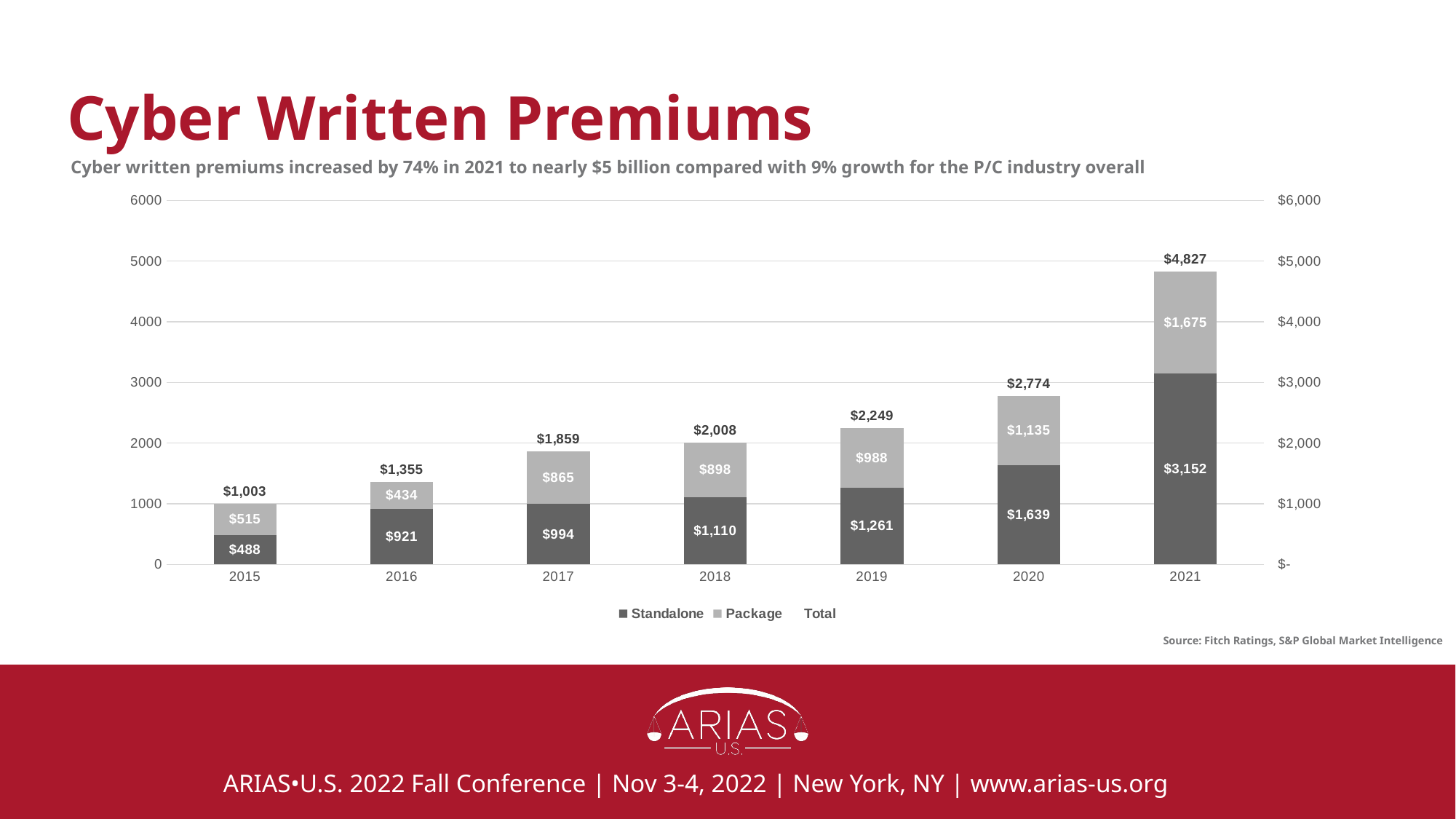
What is the source cited for the chart? Fitch Ratings, S&P Global Market Intelligence What kind of chart is shown on the slide? Stacked bar chart How many series does the legend list? 3 What is the difference between the Total values for 2021 and 2020? $2,053 Which year has the lowest Standalone value? 2015 Which is larger, the Package value for 2019 or the Package value for 2020? 2020 Which year has the highest Total value? 2021 What is the Total value for 2016? $1,355 What is the Standalone value for 2021? $3,152 What is the Package value for 2018? $898 How many years are shown on the x axis? 7 Do the Total values rise or fall from 2015 to 2021? Rise